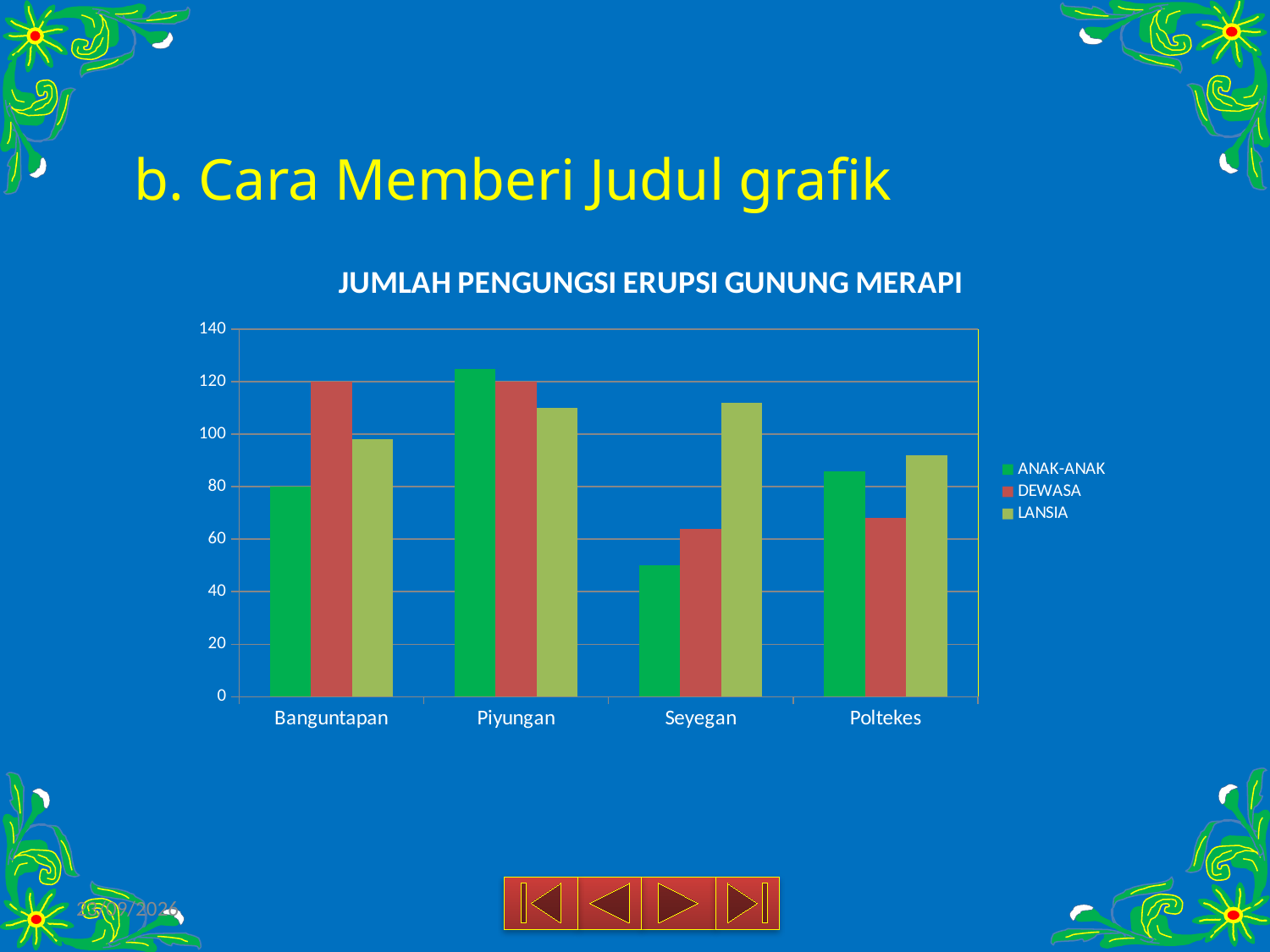
What kind of chart is shown on the slide? bar chart What is the ANAK-ANAK value for Banguntapan? 80 Is the DEWASA value for Poltekes greater or less than 80? less How many series does the legend list? 3 What is the DEWASA value for Piyungan? 120 Is the ANAK-ANAK value for Piyungan greater or less than 120? greater What is the title of the chart? JUMLAH PENGUNGSI ERUPSI GUNUNG MERAPI For Seyegan, which is larger: the LANSIA value or the DEWASA value? LANSIA Which category has the lowest ANAK-ANAK value? Seyegan Which category has the highest ANAK-ANAK value? Piyungan What is the DEWASA value for Banguntapan? 120 How many categories are shown on the x axis? 4